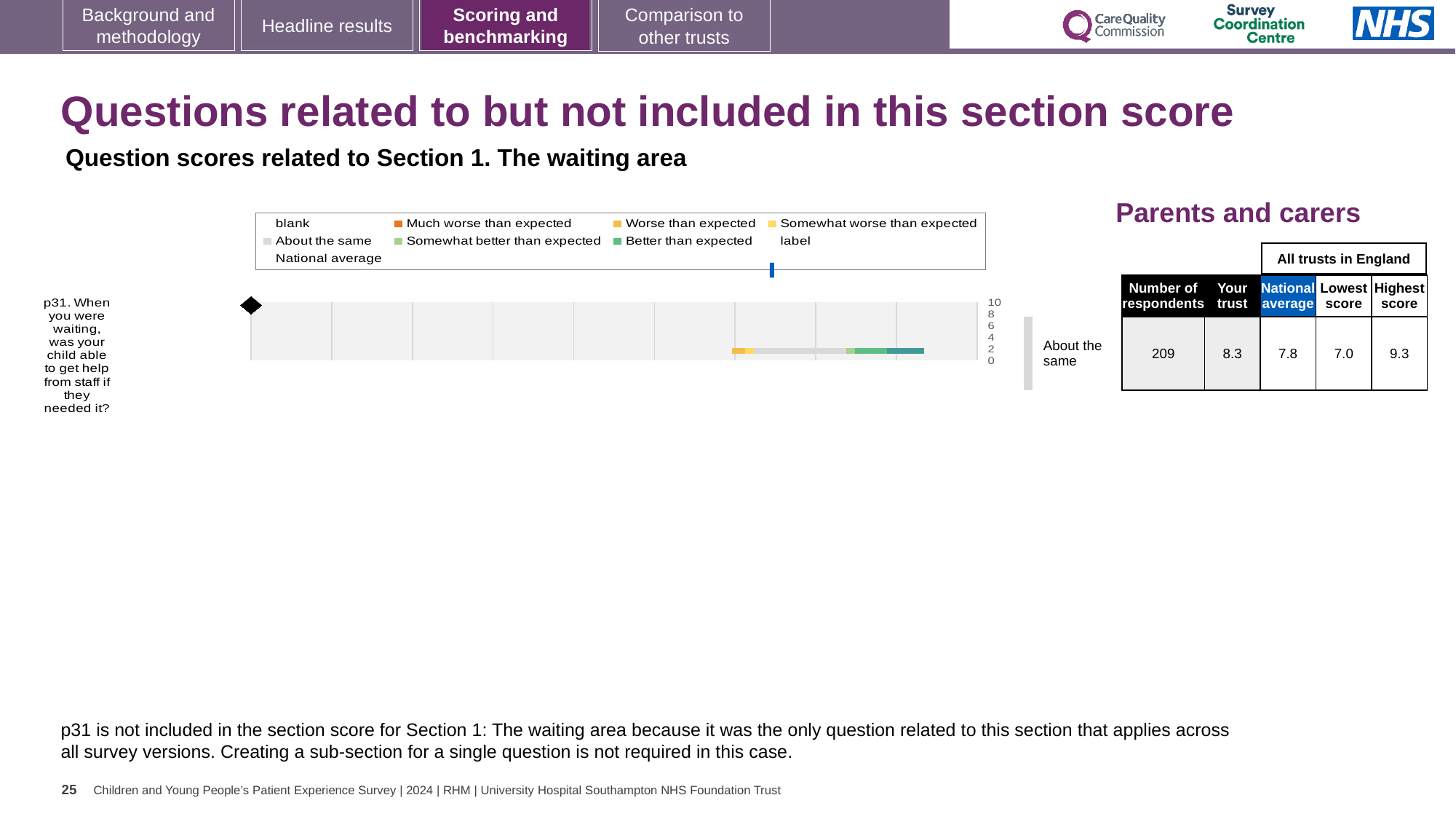
What is the difference between the highest and lowest scores across all trusts in England for p31? 2.3 What is the national average score for p31 shown in the table next to the chart? 7.8 Is the trust's score for p31 higher or lower than the national average? higher What is the highest score across all trusts in England for p31? 9.3 How many questions are plotted in the chart? 1 How many respondents answered p31? 209 What kind of chart is used to show the p31 question score? bar chart What is the lowest score across all trusts in England for p31? 7.0 What is the difference between the trust's score and the national average for p31? 0.5 Which question is plotted in the chart? p31. When you were waiting, was your child able to get help from staff if they needed it? What is the 'Your trust' score for p31 shown in the table next to the chart? 8.3 What benchmark category label is shown to the right of the p31 bar? About the same